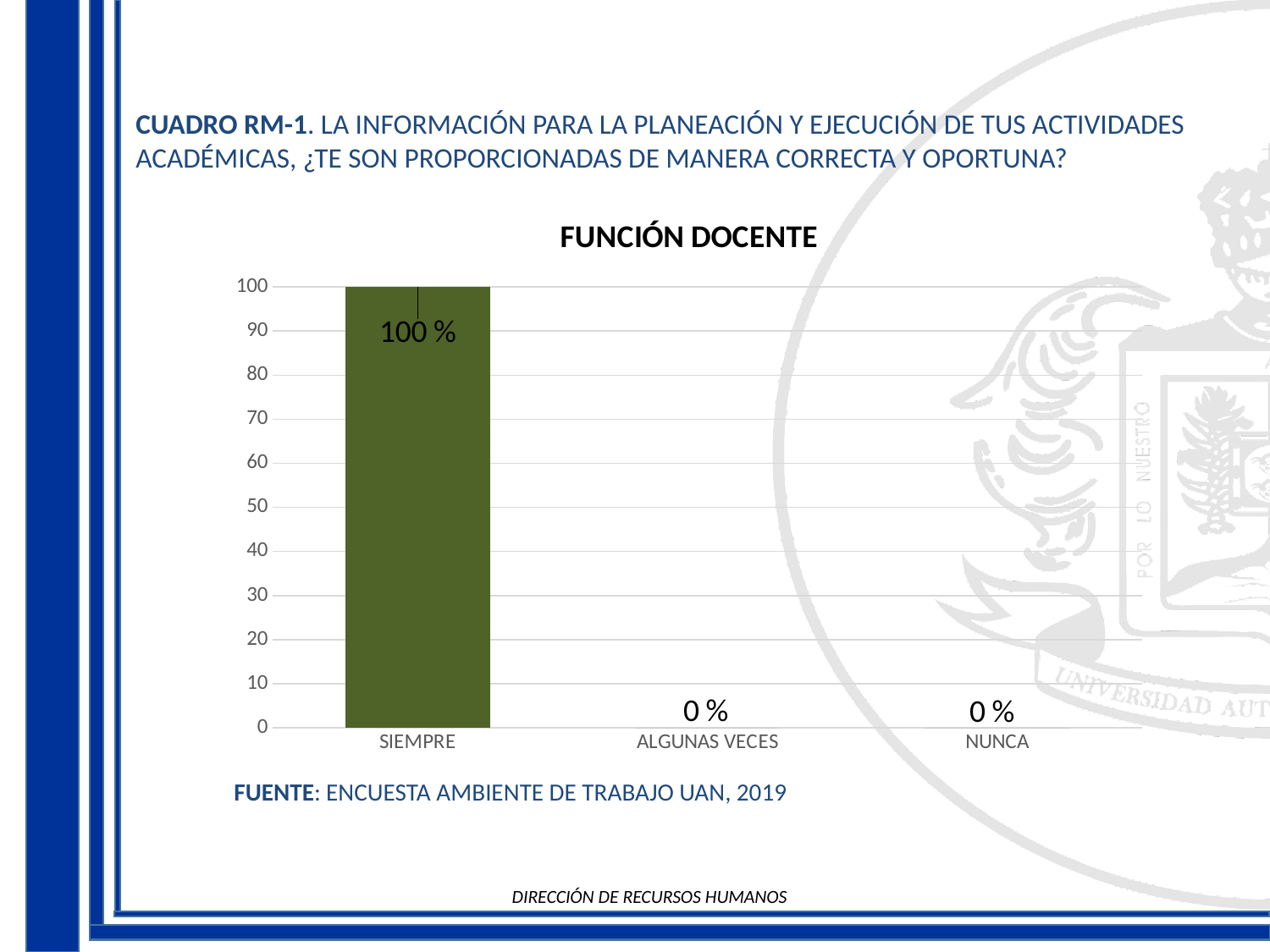
Which category has the highest value? SIEMPRE What is the value for ALGUNAS VECES? 0 % What is the value for NUNCA? 0 % What is the difference between the values for SIEMPRE and NUNCA? 100 % Do the values rise or fall from SIEMPRE to NUNCA along the x axis? fall How many categories are shown on the x axis? 3 What is the value for SIEMPRE? 100 % What is the title of the chart? FUNCIÓN DOCENTE What is the highest value shown on the y axis? 100 What kind of chart is shown on the slide? bar chart Is the value for SIEMPRE greater or less than 50? greater Which is larger, the value for SIEMPRE or the value for ALGUNAS VECES? SIEMPRE